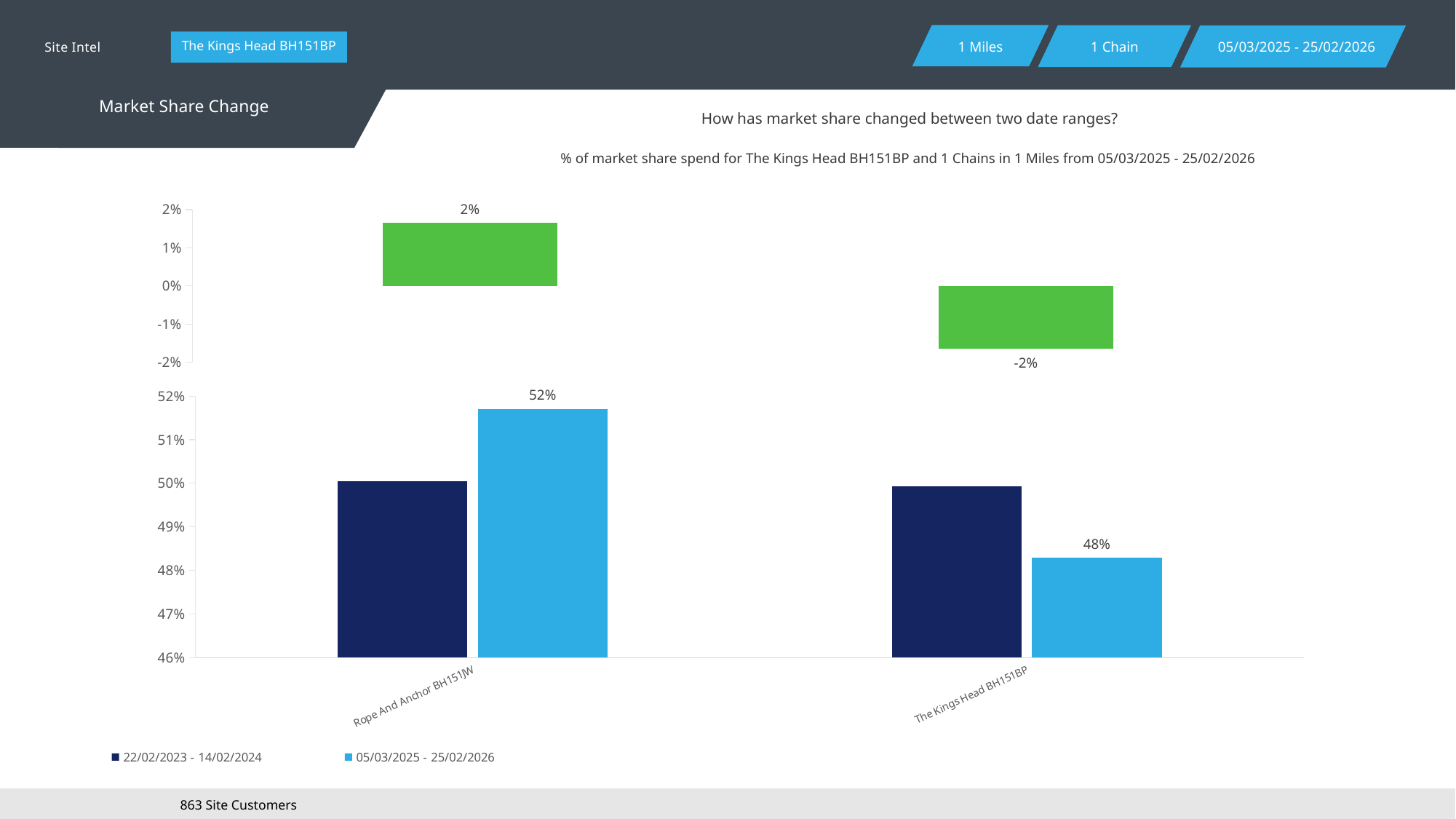
In the top chart, what is the market share change shown for Rope And Anchor BH151JW? 2% In the bottom chart, which site has the higher market share in the 05/03/2025 - 25/02/2026 period? Rope And Anchor BH151JW In the top chart, which site has the lower market share change? The Kings Head BH151BP In the bottom chart, what is the market share for Rope And Anchor BH151JW in the 05/03/2025 - 25/02/2026 period? 52% What kind of chart is the bottom chart? Bar chart How many series does the legend of the bottom chart list? 2 In the bottom chart, what is the difference between the 05/03/2025 - 25/02/2026 market shares of Rope And Anchor BH151JW and The Kings Head BH151BP? 4% In the bottom chart, is the 22/02/2023 - 14/02/2024 value for The Kings Head BH151BP greater or less than 49%? greater In the bottom chart, what is the market share for The Kings Head BH151BP in the 05/03/2025 - 25/02/2026 period? 48% In the top chart, what is the market share change shown for The Kings Head BH151BP? -2% How many sites are shown on the x axis of the bottom chart? 2 In the bottom chart, is the 22/02/2023 - 14/02/2024 value for Rope And Anchor BH151JW greater or less than 51%? less